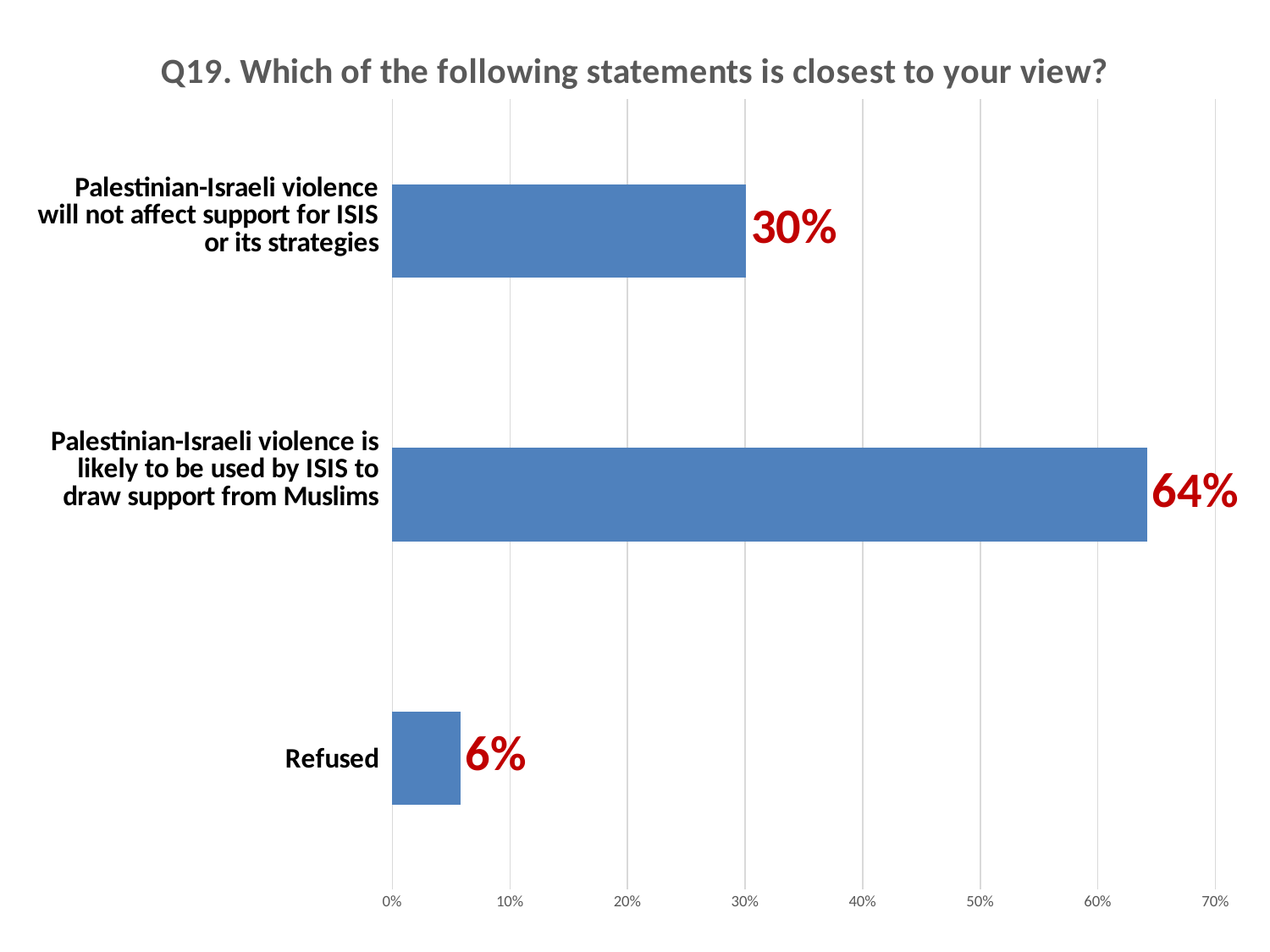
What percentage of respondents said Palestinian-Israeli violence is likely to be used by ISIS to draw support from Muslims? 64% How many categories are shown in the chart? 3 What is the difference between the share saying violence is likely to be used by ISIS to draw support and the share saying it will not affect support for ISIS? 34% What is the difference between the 'will not affect support for ISIS' share and the 'Refused' share? 24% Is the value for 'Palestinian-Israeli violence is likely to be used by ISIS to draw support from Muslims' greater or less than 50%? greater What is the title of the chart? Q19. Which of the following statements is closest to your view? What type of chart is shown on the slide? Bar chart Which category has the lowest value? Refused What percentage of respondents said Palestinian-Israeli violence will not affect support for ISIS or its strategies? 30% Which statement received the highest share of responses? Palestinian-Israeli violence is likely to be used by ISIS to draw support from Muslims Which is larger: the share saying violence will not affect support for ISIS, or the share that refused? Palestinian-Israeli violence will not affect support for ISIS or its strategies What percentage of respondents refused to answer? 6%